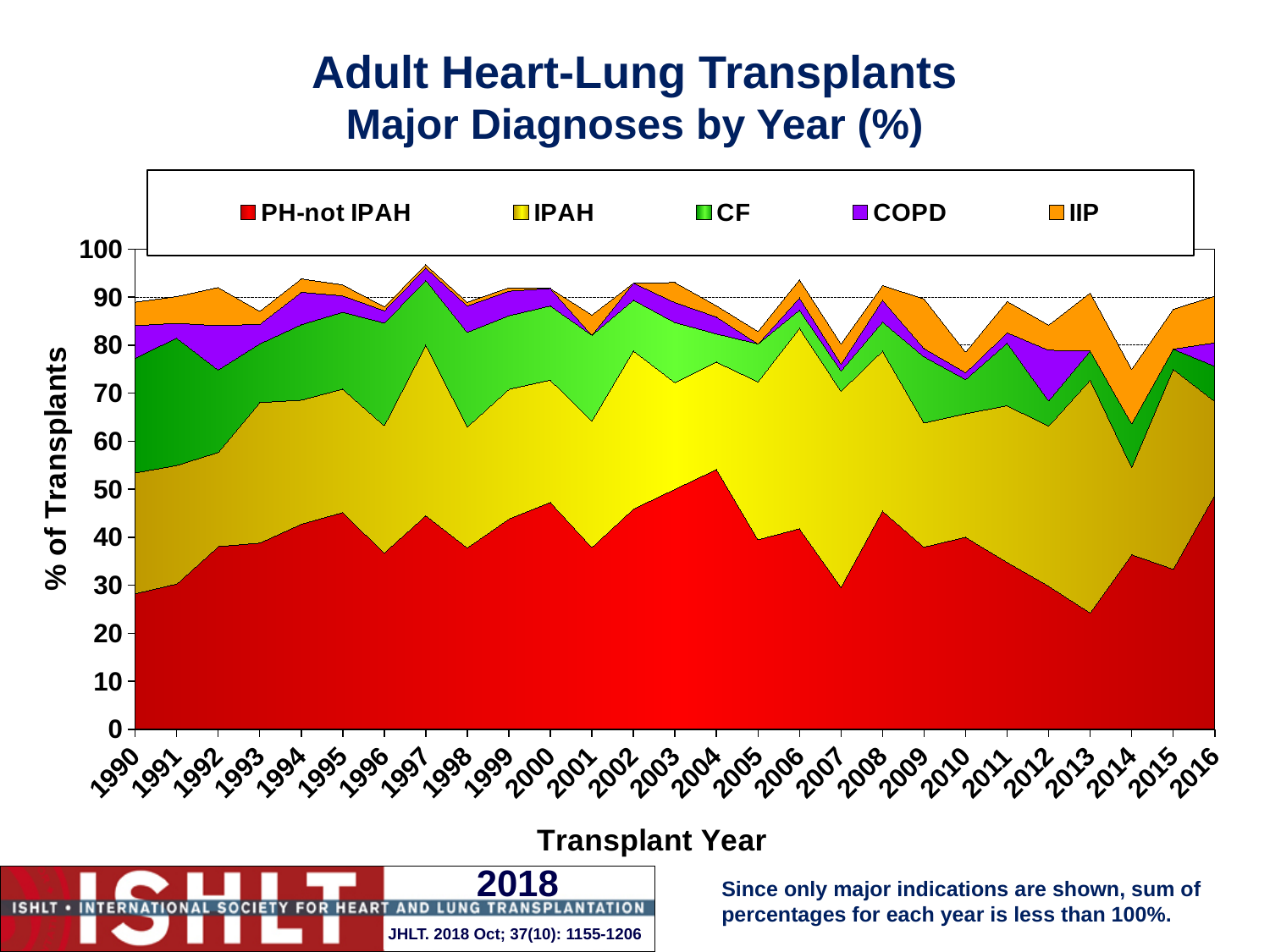
What is the last year shown on the x axis? 2016 Is the value for PH-not IPAH in 2013 greater or less than 30? less Is the total of the stacked areas in 2014 greater or less than 80? less What is the label of the y axis? % of Transplants What is the first year shown on the x axis? 1990 What kind of chart is shown on the slide? stacked area chart Which series is shown in red? PH-not IPAH How many series does the legend list? 5 Is the total of the stacked areas in 1997 greater or less than 90? greater How many transplant years are plotted along the x axis? 27